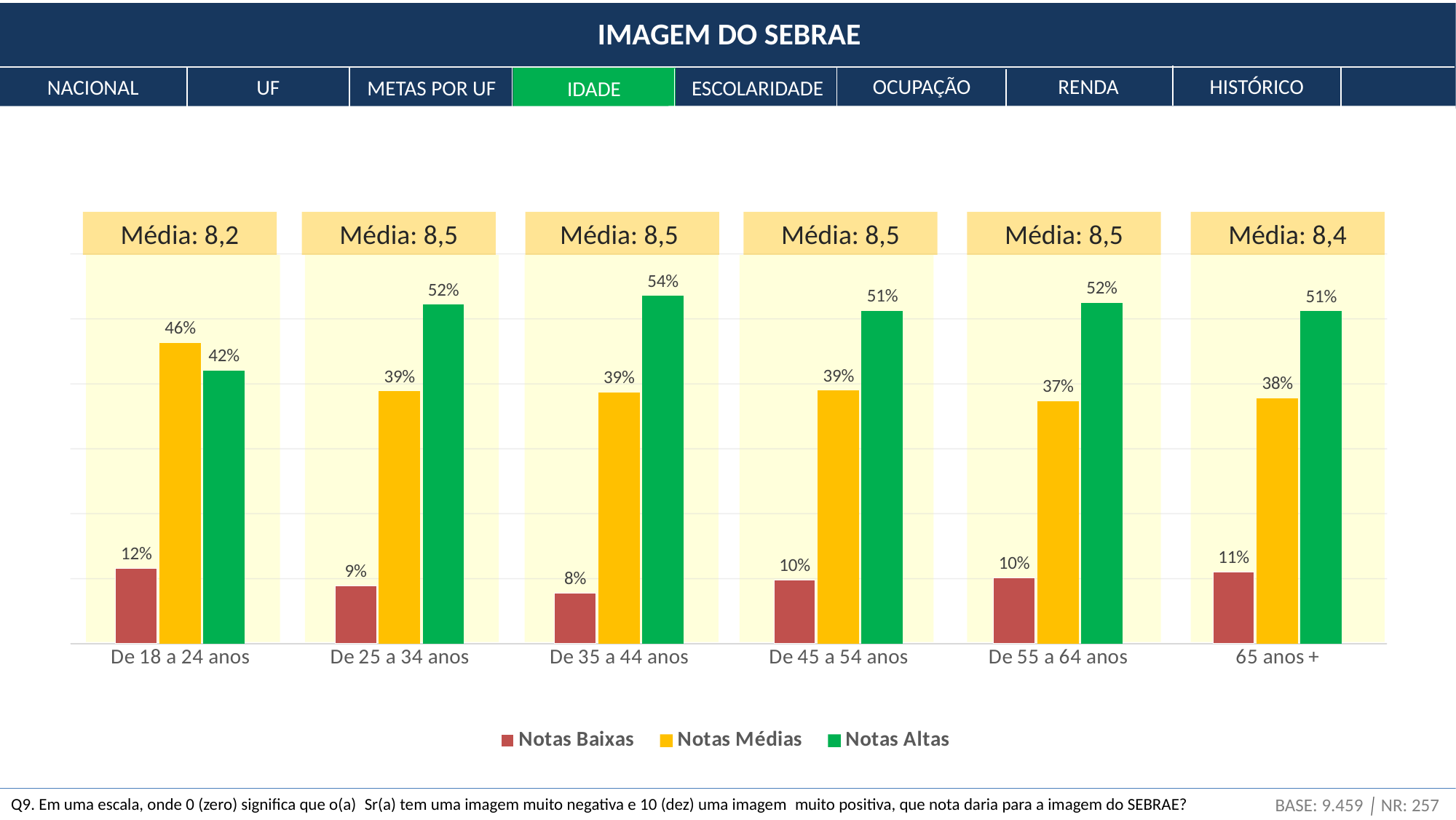
What is the value of Notas Médias for 65 anos +? 38% Which is larger for De 18 a 24 anos: Notas Médias or Notas Altas? Notas Médias Which age group has the lowest Notas Baixas value? De 35 a 44 anos What is the difference between Notas Altas and Notas Médias for De 25 a 34 anos? 13 percentage points How many series does the legend list? 3 How many age groups are shown on the x axis? 6 Which age group has the highest Notas Médias value? De 18 a 24 anos What is the value of Notas Altas for De 35 a 44 anos? 54% What is the Média shown for De 18 a 24 anos? 8,2 What kind of chart is shown on the slide? Bar chart What is the value of Notas Baixas for De 18 a 24 anos? 12% Which age group has the highest Notas Altas value? De 35 a 44 anos